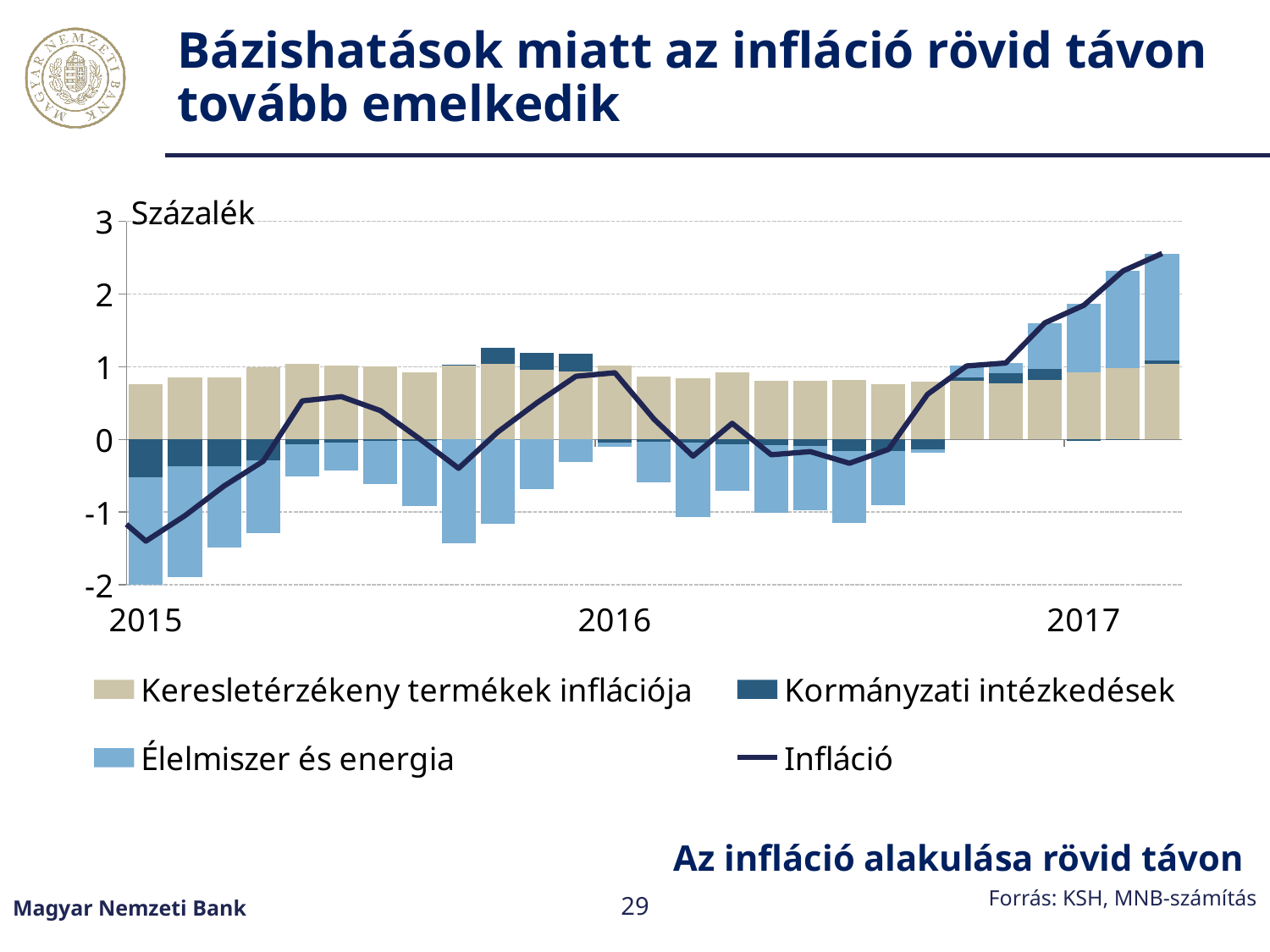
What is the title of the chart shown below the legend? Az infláció alakulása rövid távon What kind of chart is shown on the slide? A stacked bar chart with a line In which year does the Infláció line reach its lowest value? 2015 How many series does the legend list? 4 Is the value of the Infláció line at its last point in 2017 greater or less than 2? greater Which legend entry is drawn as a line rather than bars? Infláció Is the value of the Infláció line at the start of 2016 greater or less than 0? greater In which year does the Infláció line reach its highest value? 2017 What unit label is shown at the top of the vertical axis? Százalék Is the value of the Infláció line at the start of 2015 greater or less than 0? less Does the Infláció line overall rise or fall from 2015 to 2017? Rise Which is larger: the Infláció value at the start of 2015 or at the start of 2017? Start of 2017